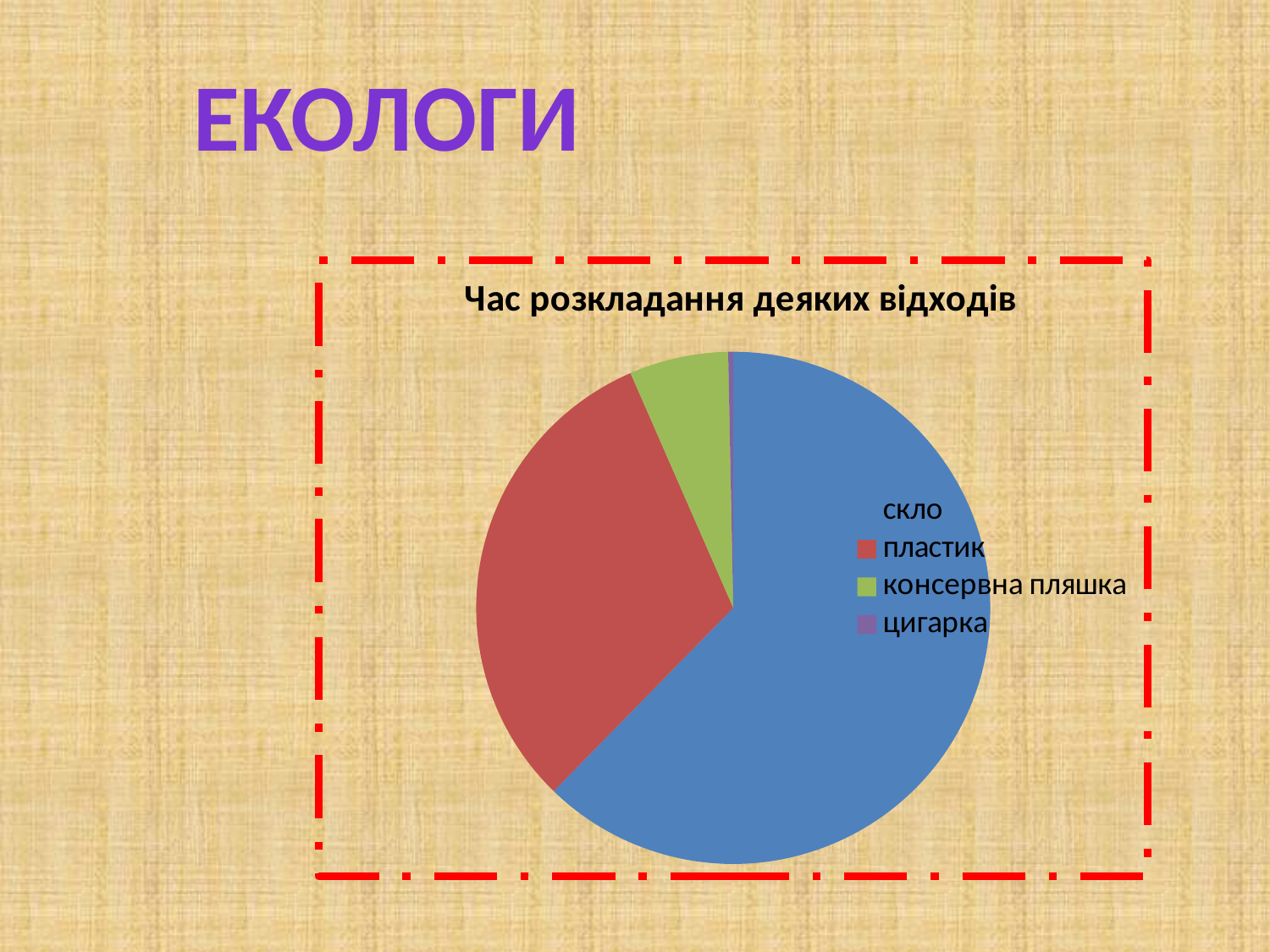
Does the slice for скло take up more or less than half of the pie? more Which category has the largest slice of the pie? скло Which slice is larger, скло or пластик? скло Which slice is larger, пластик or консервна пляшка? пластик Which category has the smallest slice of the pie? цигарка What is the title of the chart? Час розкладання деяких відходів How many categories does the legend of the pie chart list? 4 Which category is shown in red in the pie chart? пластик What kind of chart is shown on the slide? pie chart Which category is shown in green in the pie chart? консервна пляшка